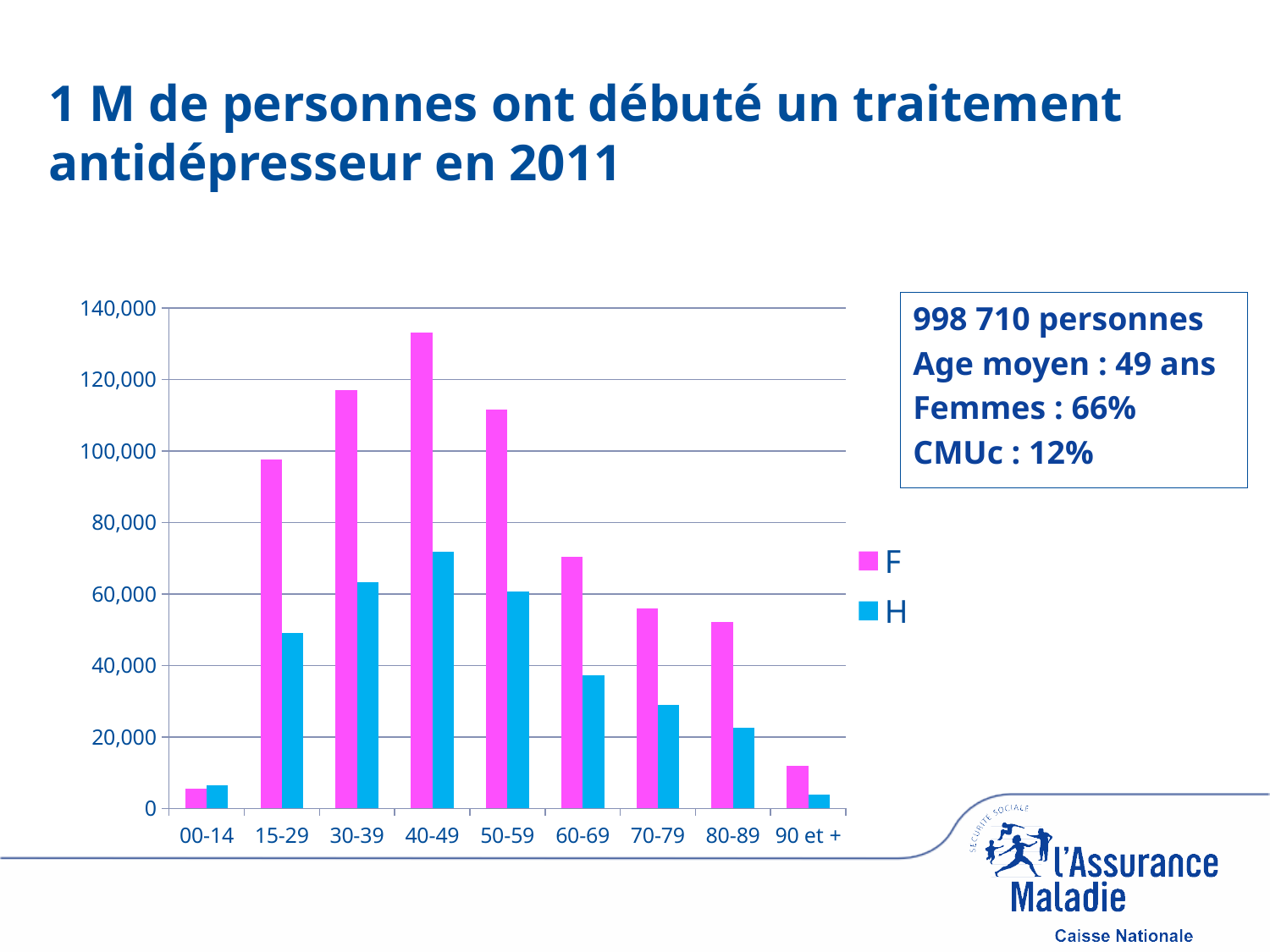
Which is larger for the F series: the 15-29 category or the 50-59 category? 50-59 Which age category has the highest value for the H series? 40-49 How many series does the legend list? 2 Is the value for H in the 15-29 category greater or less than 60,000? less Which age category has the highest value for the F series? 40-49 Do the F values rise or fall along the x axis from 40-49 to 90 et +? fall Is the value for F in the 40-49 category greater or less than 120,000? greater What are the two entries listed in the legend? F and H What kind of chart is shown on the slide? bar chart Is the value for F in the 60-69 category greater or less than 60,000? greater Which age category has the lowest value for the F series? 00-14 How many age categories are shown on the x axis? 9